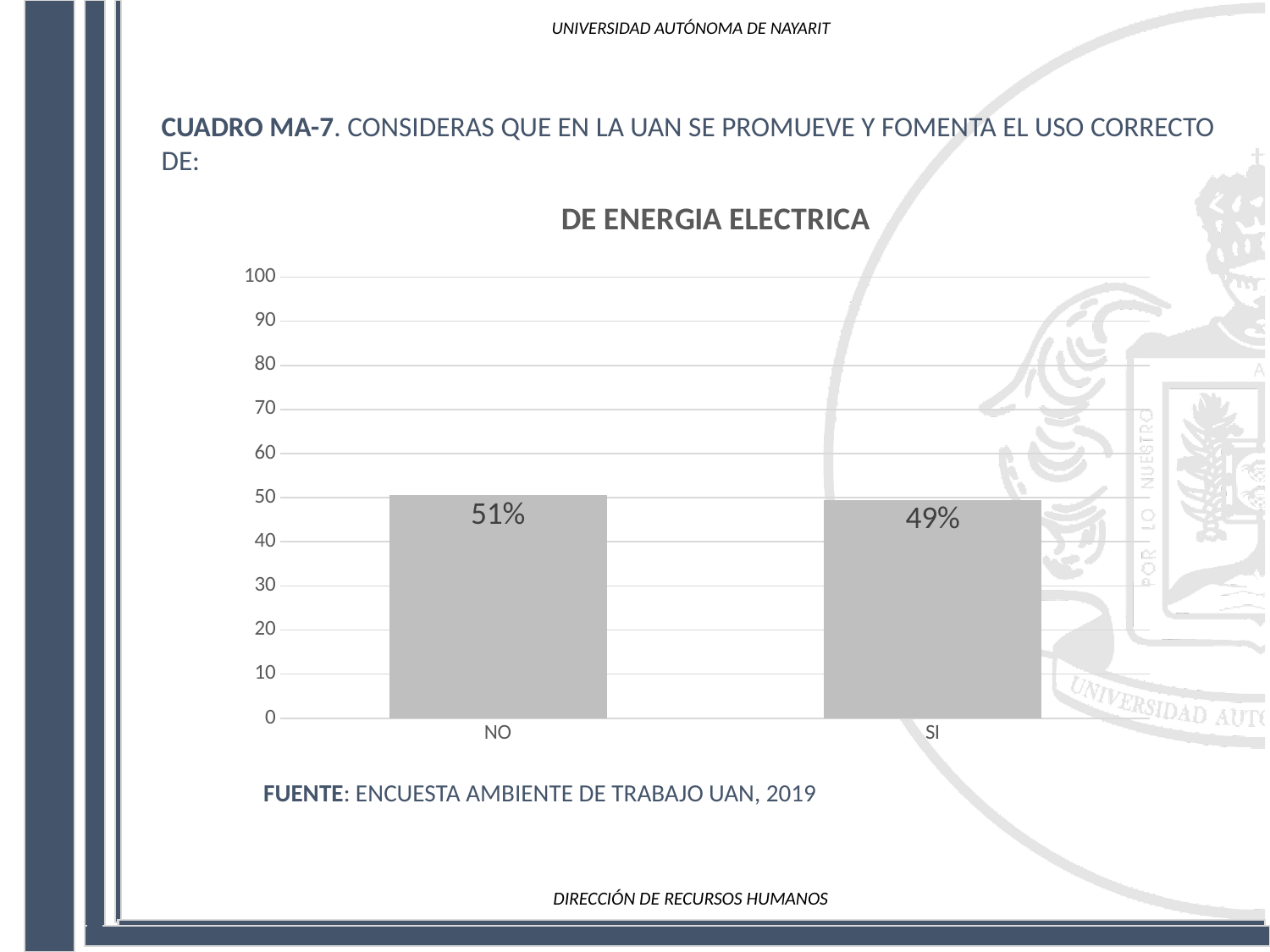
What is the difference between the values for NO and SI? 2% Which category has the lowest value? SI Is the value for SI greater or less than 60? less Is the value for NO greater or less than 40? greater What is the maximum value shown on the y axis? 100 Which is larger, the value for NO or the value for SI? NO What is the title of the chart? DE ENERGIA ELECTRICA What is the value for NO? 51% Which category has the highest value? NO How many categories are shown on the x axis? 2 What kind of chart is shown? bar chart What is the value for SI? 49%